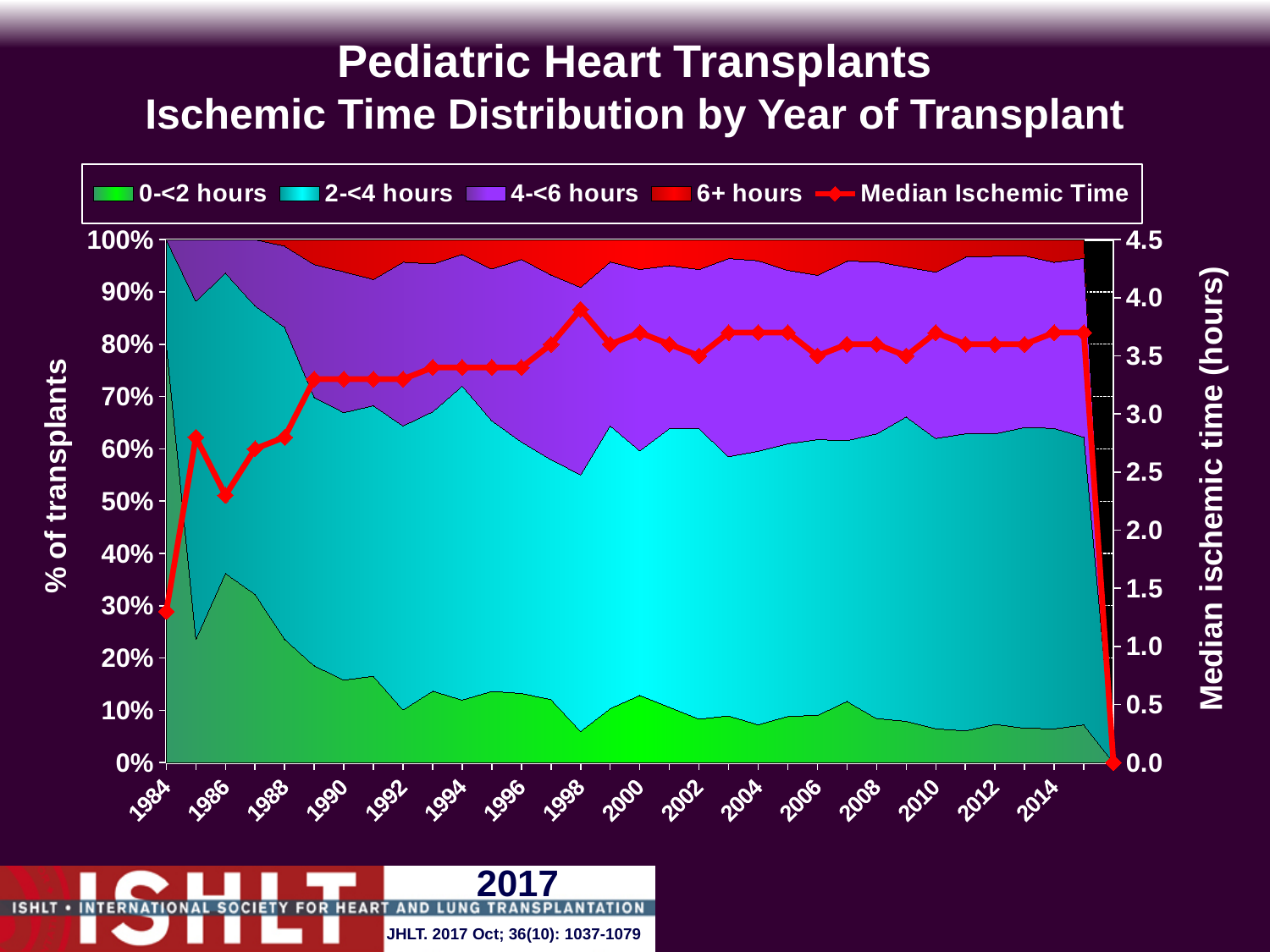
Which is larger, the Median Ischemic Time in 1984 or in 2014? 2014 Is the share of transplants with 0-<2 hours ischemic time in 2014 greater or less than 10%? less Is the Median Ischemic Time for 1990 greater or less than 3.0 hours? greater What is the label of the right-hand vertical axis? Median ischemic time (hours) Does the Median Ischemic Time generally rise or fall from 1984 to 1998? rise How many year labels are shown on the x axis? 16 Is the Median Ischemic Time for 1998 greater or less than 3.5 hours? greater What kind of chart is this? Stacked area chart with a line overlay What is the title of the chart? Pediatric Heart Transplants Ischemic Time Distribution by Year of Transplant How many series does the legend list? 5